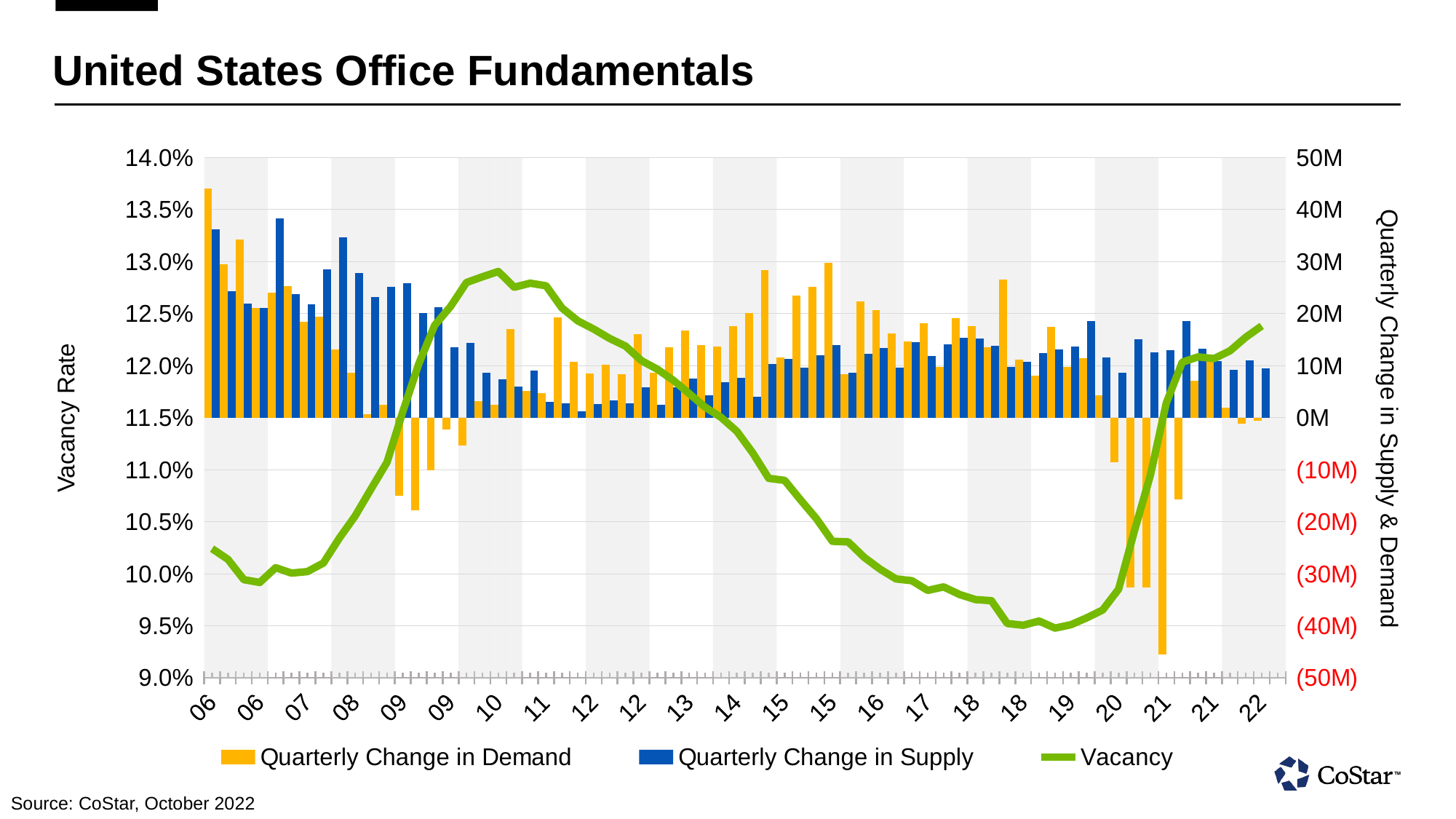
What kind of chart is this? Combined bar and line chart What is the title of the chart? United States Office Fundamentals Does the Vacancy line rise or fall between the 19 label and the 22 label? rise Which series is plotted as a line rather than bars? Vacancy Is the lowest Quarterly Change in Demand bar (near the 21 label) greater or less than (40M)? less Is the first Quarterly Change in Demand bar (at the 06 label) greater or less than 40M? greater Does the Vacancy line rise or fall between the 10 label and the 19 label? fall How many series does the legend list? 3 Is the peak value of the Vacancy line greater or less than 12.5%? greater Around which year label does the Vacancy line reach its lowest point? 19 Around which year label does the Vacancy line reach its highest point? 10